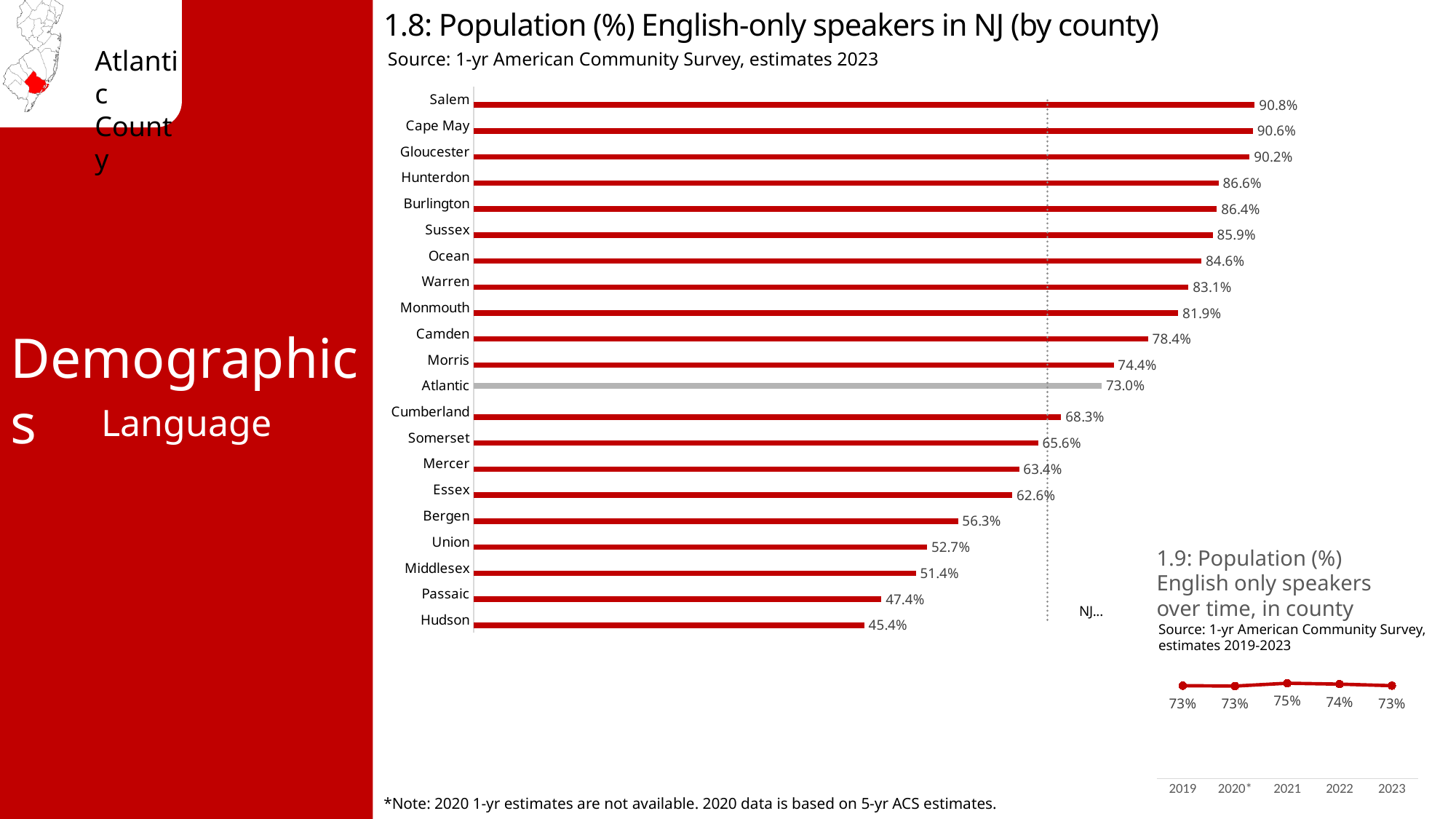
In chart 1.8, which county's bar is shown in grey instead of red? Atlantic In chart 1.9, what is the value for 2021? 75% In chart 1.8, how many counties are shown? 21 What kind of chart is chart 1.8? Bar chart In chart 1.8, what is the value for Atlantic? 73.0% In chart 1.8, which has a larger value, Camden or Morris? Camden In chart 1.8, which county has the highest percentage of English-only speakers? Salem In chart 1.8, what is the difference between the values for Salem and Hudson? 45.4 percentage points In chart 1.8, which county has the lowest percentage of English-only speakers? Hudson In chart 1.9, how many years are plotted? 5 In chart 1.8, what is the value for Hudson? 45.4% What kind of chart is chart 1.9? Line chart